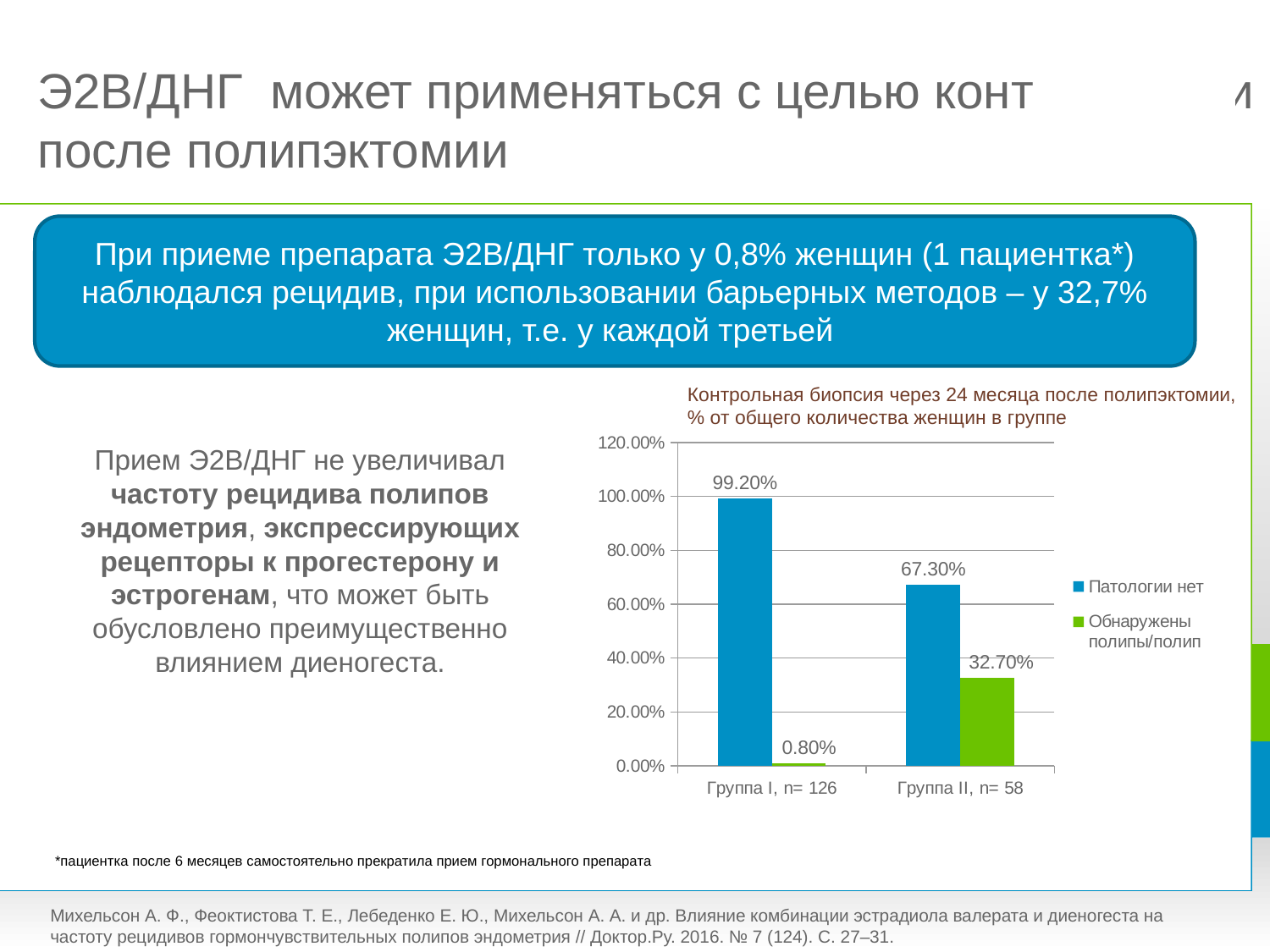
What is the value of "Обнаружены полипы/полип" for "Группа I, n= 126"? 0.80% How many groups (categories) are shown on the x axis? 2 What is the value of "Патологии нет" for "Группа II, n= 58"? 67.30% What is the difference between the "Патологии нет" values of Группа I and Группа II? 31.90% Which group has the lower value for "Патологии нет"? Группа II, n= 58 Is the "Патологии нет" value for Группа II greater or less than 60.00%? greater How many series does the legend list? 2 What is the value of "Патологии нет" for "Группа I, n= 126"? 99.20% What is the value of "Обнаружены полипы/полип" for "Группа II, n= 58"? 32.70% What kind of chart is shown on the slide? bar chart Which group has the higher value for "Обнаружены полипы/полип"? Группа II, n= 58 What is the difference between the "Обнаружены полипы/полип" values of Группа II and Группа I? 31.90%